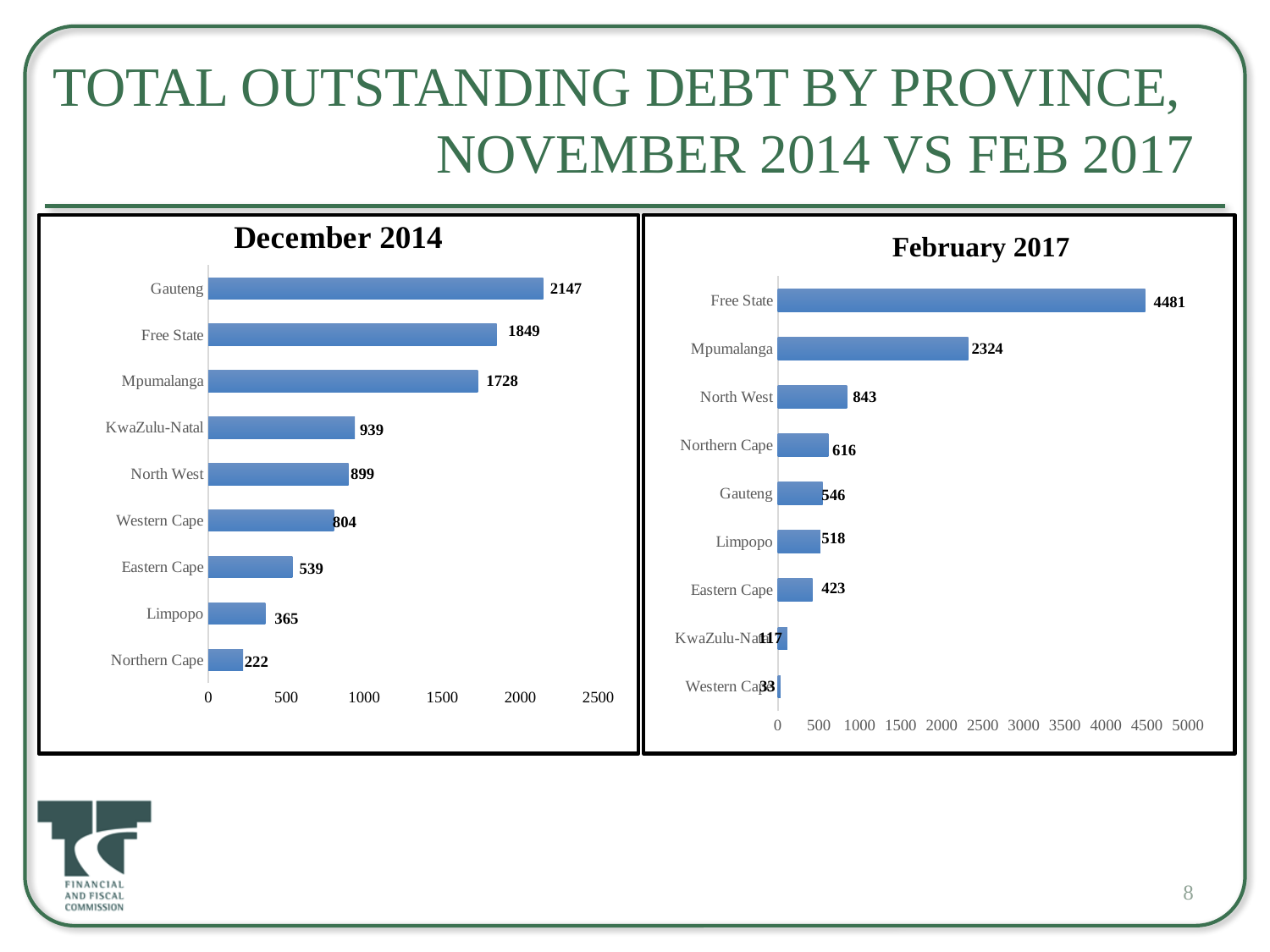
In the February 2017 chart, which province has the highest value? Free State In the February 2017 chart, what is the difference between Free State and Mpumalanga? 2157 In the February 2017 chart, what is the value for Free State? 4481 In the December 2014 chart, what is the value for Limpopo? 365 In the December 2014 chart, which province has the lowest value? Northern Cape How many provinces are shown in the December 2014 chart? 9 In the December 2014 chart, which is larger, KwaZulu-Natal or North West? KwaZulu-Natal What type of chart is the February 2017 chart? Bar chart In the February 2017 chart, which province has the lowest value? Western Cape In the February 2017 chart, which is larger, North West or Northern Cape? North West In the December 2014 chart, what is the value for Gauteng? 2147 In the December 2014 chart, what is the difference between Gauteng and Free State? 298